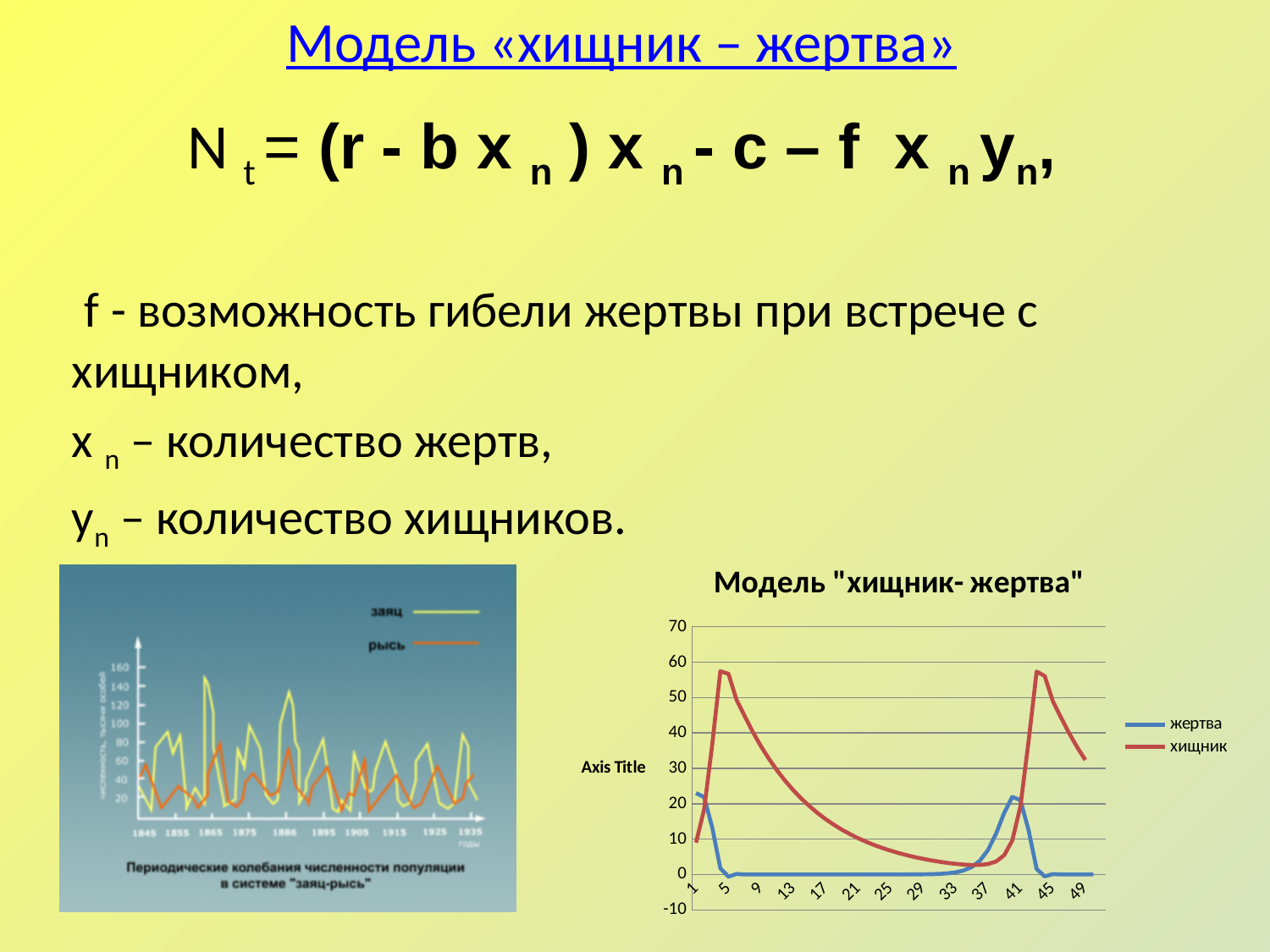
In the left chart (заяц-рысь), which series reaches the higher peak values, заяц or рысь? заяц In the right chart 'Модель "хищник- жертва"', does the хищник series rise or fall between x = 5 and x = 33? fall In the right chart 'Модель "хищник- жертва"', which series reaches the higher peak value, жертва or хищник? хищник What are the two series named in the legend of the right chart 'Модель "хищник- жертва"'? жертва, хищник How many series does the legend of the right chart 'Модель "хищник- жертва"' list? 2 In the right chart 'Модель "хищник- жертва"', is the value of the хищник series at x = 25 greater or less than 20? less What kind of chart is the left chart showing the заяц and рысь populations? line chart What kind of chart is the chart titled 'Модель "хищник- жертва"' on the right of the slide? line chart What is the title shown on the vertical axis of the right chart 'Модель "хищник- жертва"'? Axis Title How many series does the legend of the left chart (заяц-рысь) list? 2 In the right chart 'Модель "хищник- жертва"', is the peak value of the жертва series greater or less than 30? less In the right chart 'Модель "хищник- жертва"', is the peak value of the хищник series greater or less than 50? greater